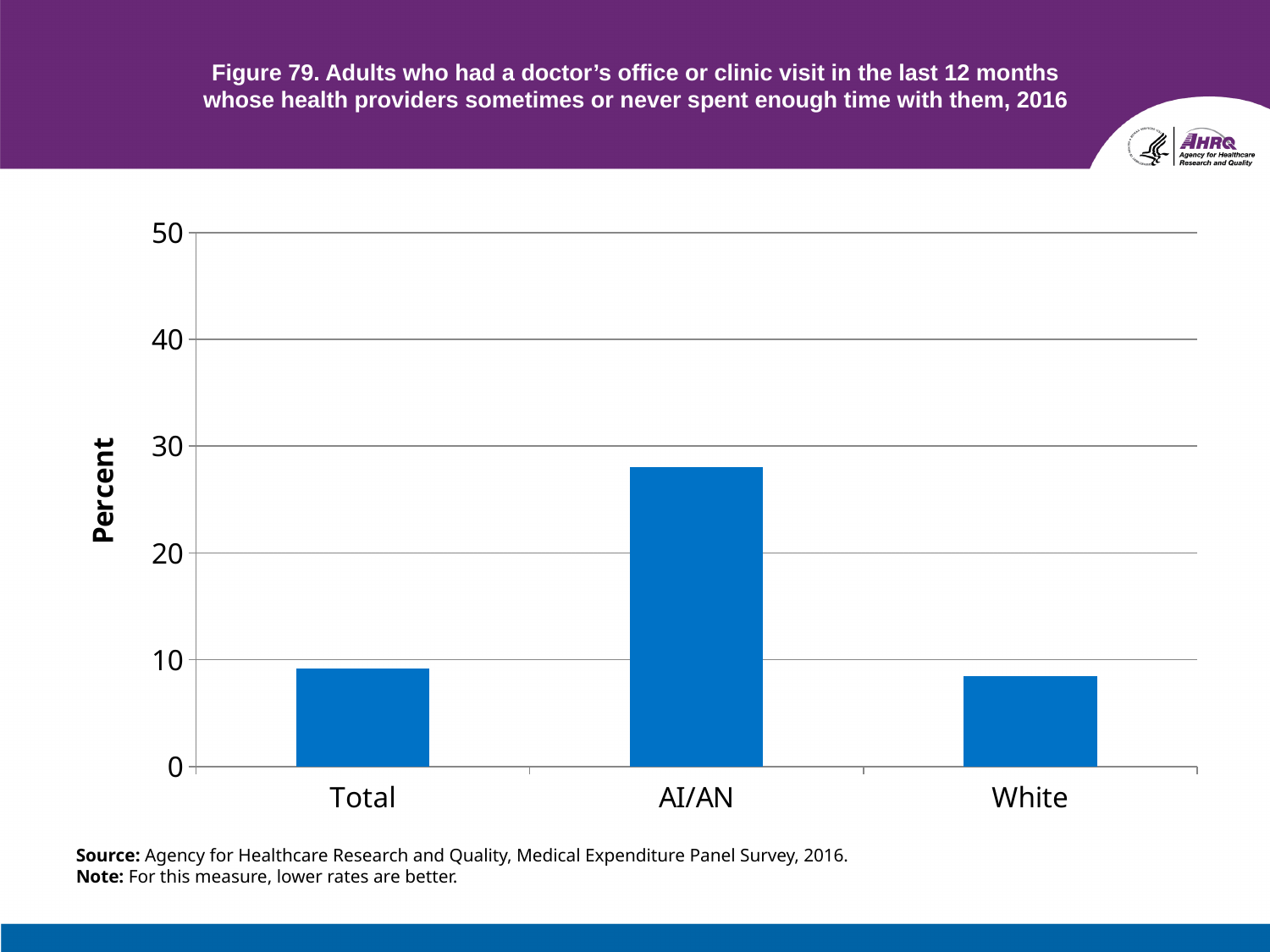
Which category has the highest value in the chart? AI/AN Is the value for White greater or less than 10? less Which is larger, the value for AI/AN or the value for White? AI/AN Is the value for AI/AN greater or less than 20? greater What is the label on the y axis of the chart? Percent Is the value for Total greater or less than 10? less How many categories are shown on the x axis of the chart? 3 Which is larger, the value for Total or the value for AI/AN? AI/AN What kind of chart is shown on the slide? bar chart What is the maximum value shown on the y axis of the chart? 50